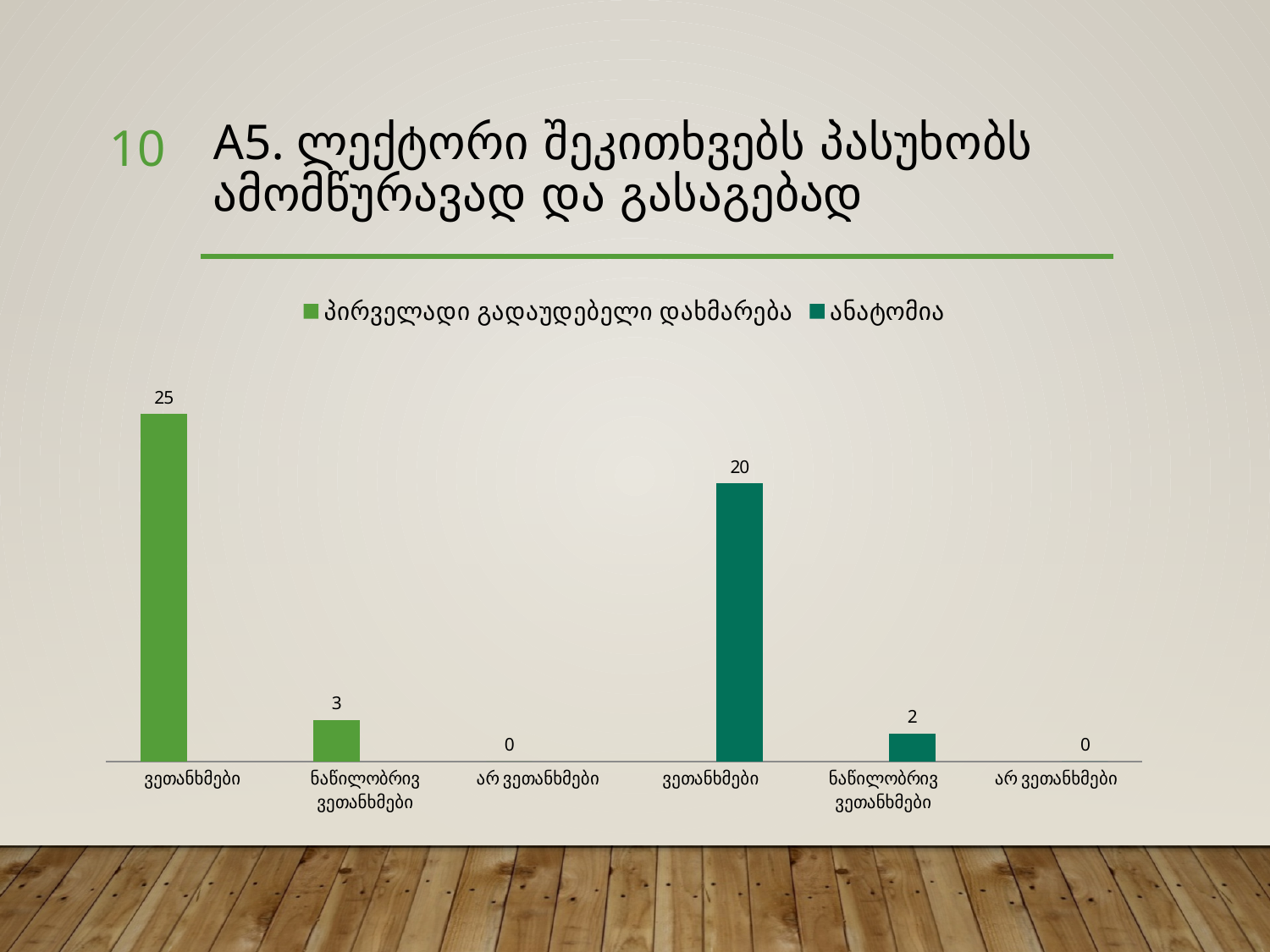
What is the difference between the "ვეთანხმები" values of the "პირველადი გადაუდებელი დახმარება" and "ანატომია" series? 5 How many bars are plotted on the chart in total? 4 What is the value for "არ ვეთანხმები" in the "ანატომია" series? 0 Which is larger: "ნაწილობრივ ვეთანხმები" for "პირველადი გადაუდებელი დახმარება" or for "ანატომია"? პირველადი გადაუდებელი დახმარება How many series does the legend list? 2 What is the value for "ნაწილობრივ ვეთანხმები" in the "ანატომია" series? 2 What type of chart is shown on the slide? bar chart Which bar has the highest value on the chart? ვეთანხმები (პირველადი გადაუდებელი დახმარება) What is the title of the slide? A5. ლექტორი შეკითხვებს პასუხობს ამომწურავად და გასაგებად What is the value for "ვეთანხმები" in the "ანატომია" series? 20 What is the value for "ვეთანხმები" in the "პირველადი გადაუდებელი დახმარება" series? 25 What is the value for "ნაწილობრივ ვეთანხმები" in the "პირველადი გადაუდებელი დახმარება" series? 3